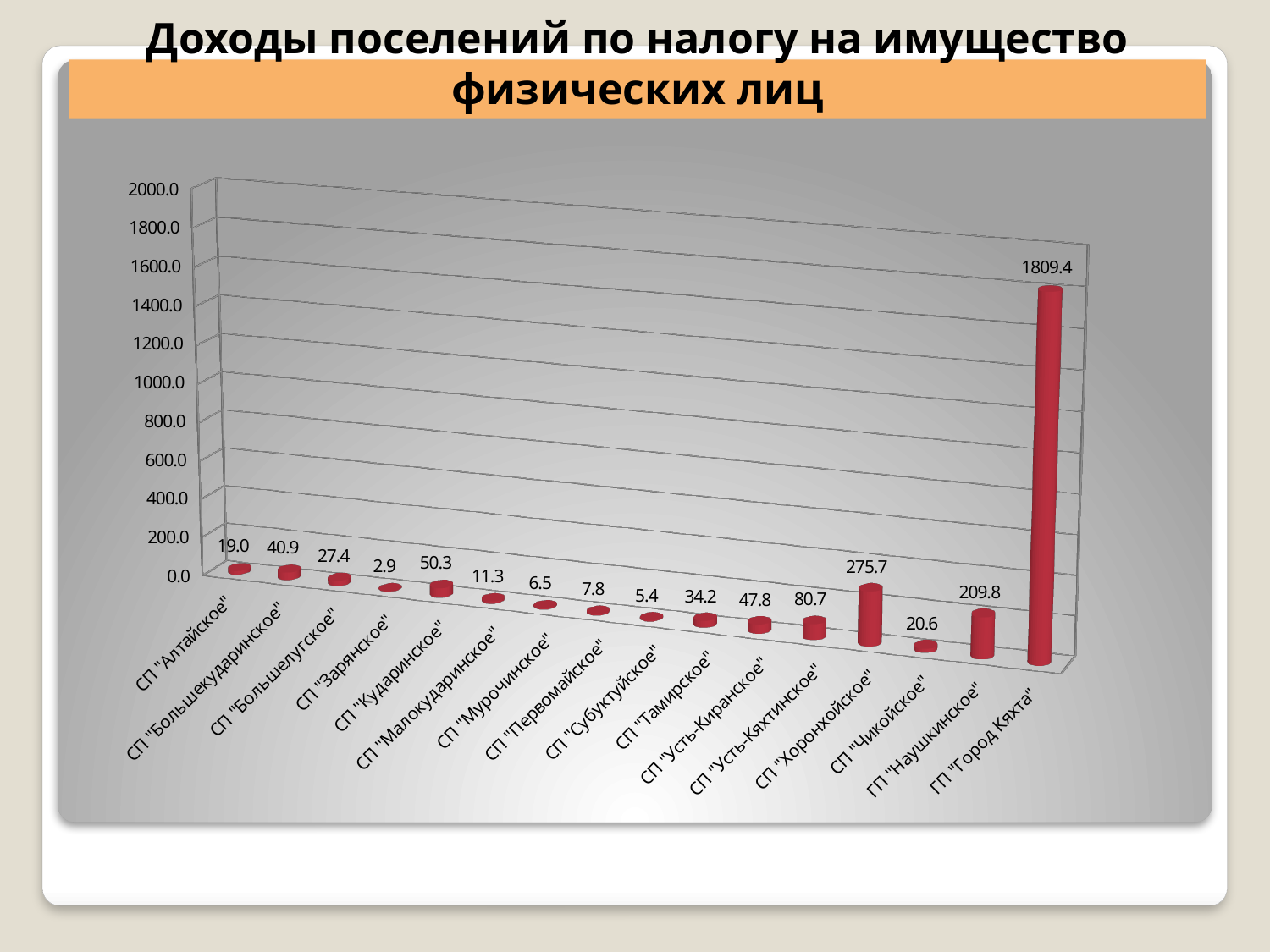
Which category has the highest value? ГП "Город Кяхта" How many categories are shown on the x axis? 16 What kind of chart is shown on the slide? Bar chart What is the value for ГП "Город Кяхта"? 1809.4 Which is larger, the value for СП "Кударинское" or the value for СП "Тамирское"? СП "Кударинское" What is the title of the chart? Доходы поселений по налогу на имущество физических лиц What is the value for СП "Хоронхойское"? 275.7 What is the difference between the values for ГП "Наушкинское" and СП "Усть-Кяхтинское"? 129.1 Which category has the lowest value? СП "Зарянское" What is the difference between the values for ГП "Город Кяхта" and СП "Хоронхойское"? 1533.7 What is the value for СП "Чикойское"? 20.6 What is the value for СП "Усть-Кяхтинское"? 80.7